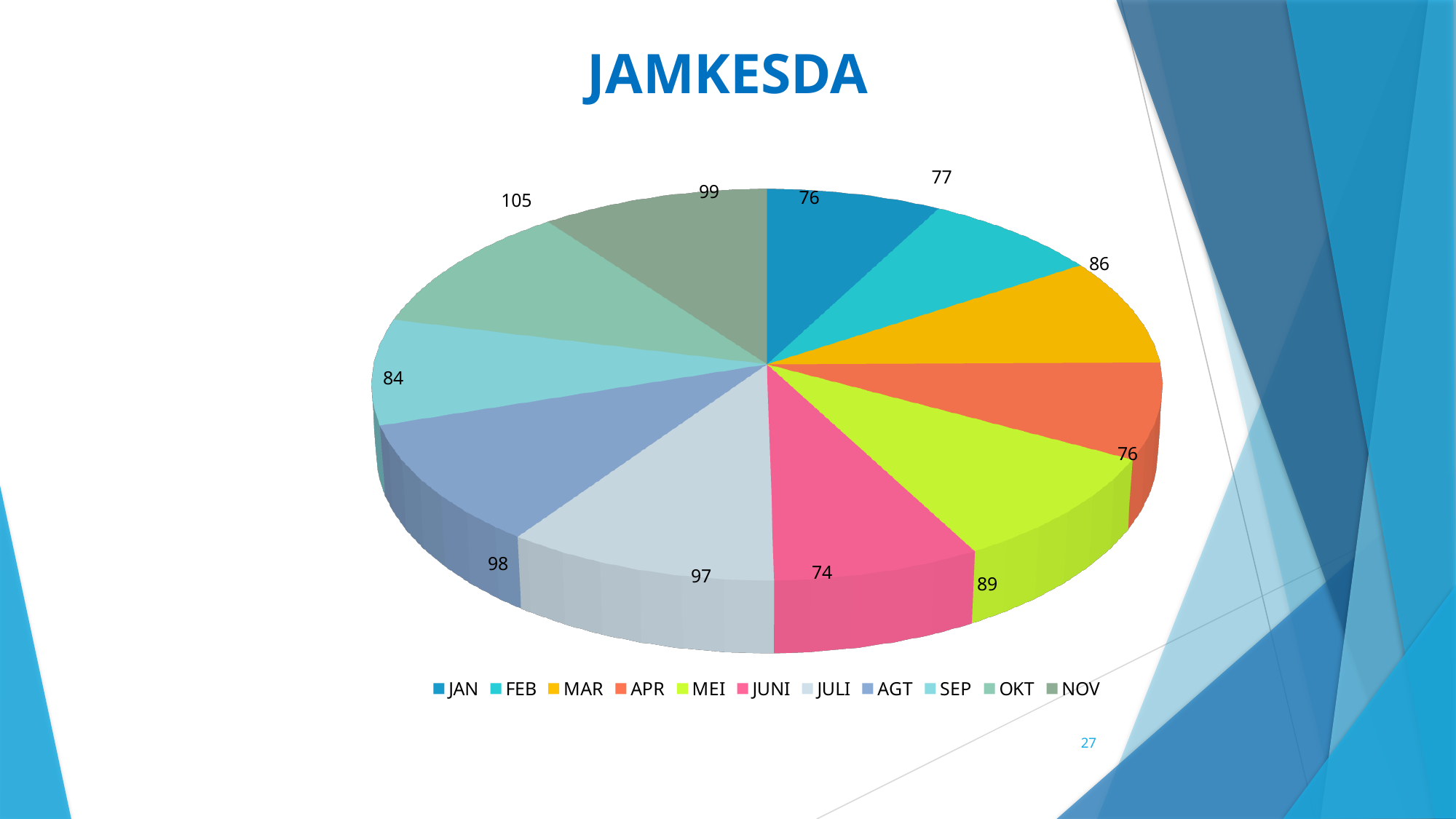
What is the difference between the values for OKT and JUNI? 31 What is the value for OKT in the JAMKESDA pie chart? 105 What is the value for MAR in the JAMKESDA pie chart? 86 What is the value for AGT in the JAMKESDA pie chart? 98 Which is larger, the value for MEI or the value for FEB? MEI What type of chart is shown on the slide? Pie chart How many months (slices) are shown in the JAMKESDA pie chart? 11 What is the value for JUNI in the JAMKESDA pie chart? 74 What is the difference between the values for NOV and SEP? 15 What is the title of the chart on the slide? JAMKESDA Which month has the smallest slice in the JAMKESDA pie chart? JUNI Which month has the largest slice in the JAMKESDA pie chart? OKT